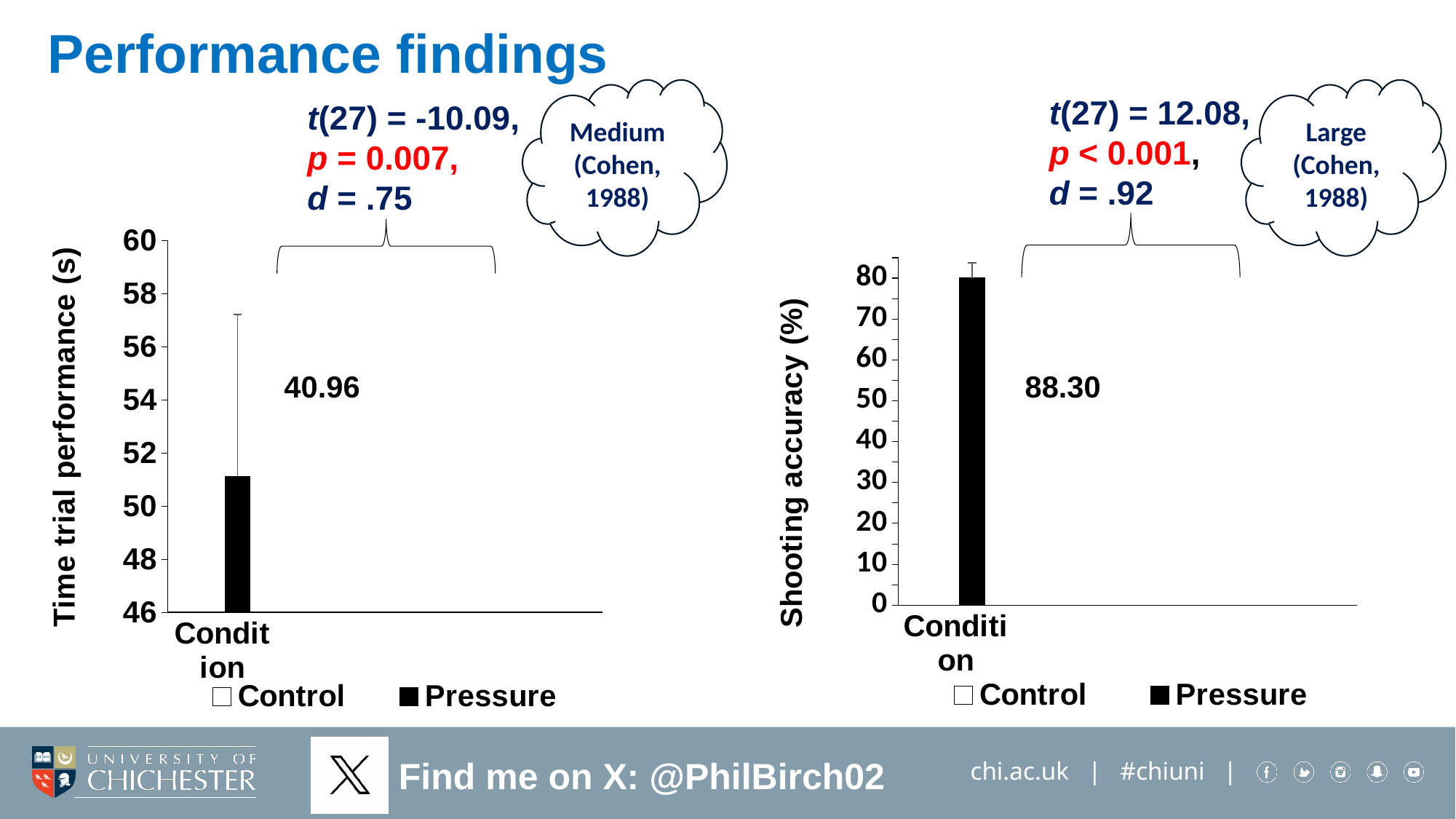
What kind of chart is the left chart (Time trial performance)? bar chart What data label is printed on the left chart? 40.96 How many series does the legend of the left chart list? 2 How many categories are shown on the x axis of the right chart? 1 On the right chart, is the value of the Pressure bar greater or less than 90? less On the left chart, is the value of the Pressure bar greater or less than 50? greater On the left chart, is the value of the Pressure bar greater or less than 54? less What kind of chart is the right chart (Shooting accuracy)? bar chart What are the two legend entries on the right chart? Control and Pressure How many series does the legend of the right chart list? 2 What is the y-axis title of the left chart? Time trial performance (s)